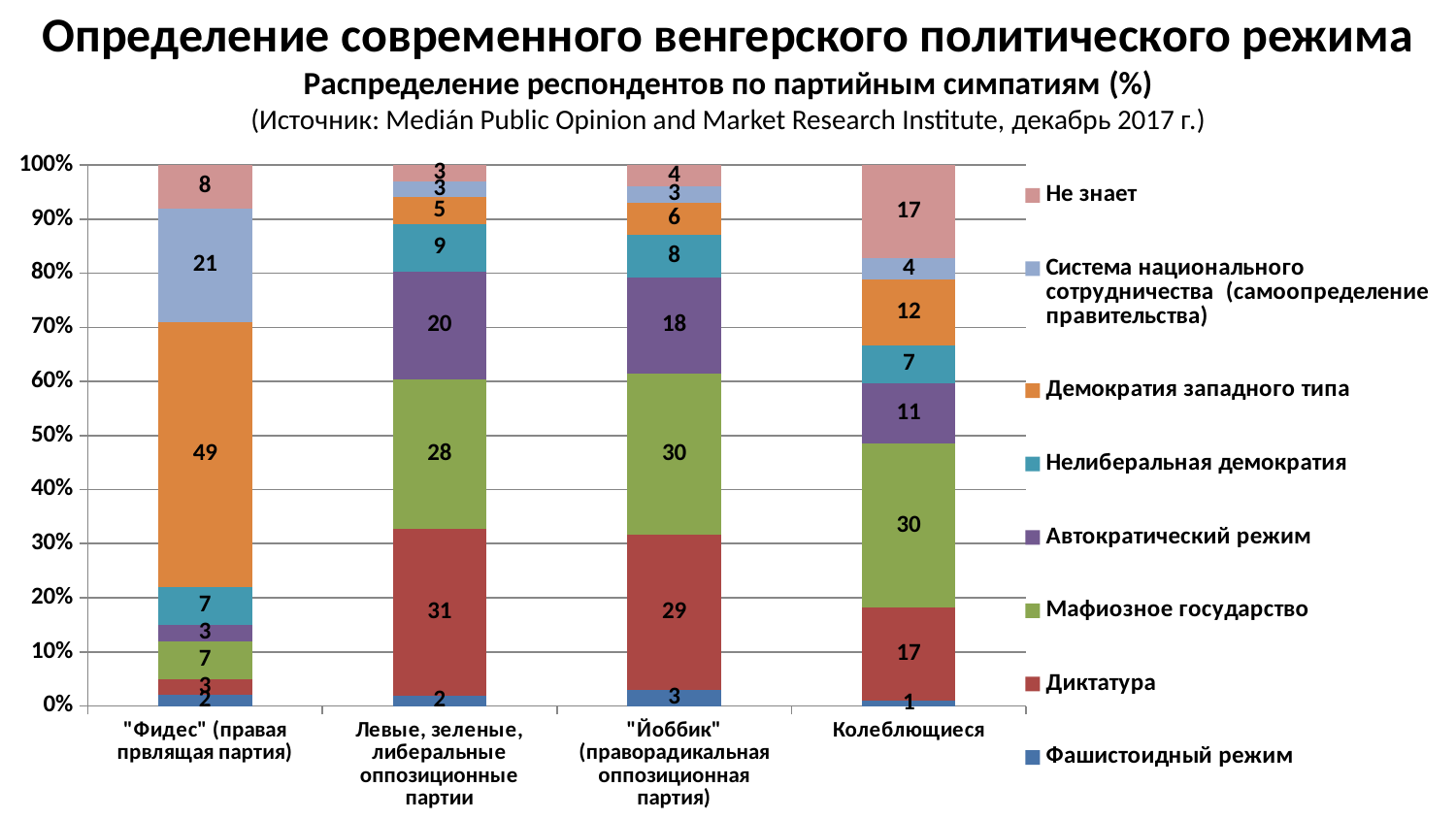
What is the value for "Не знает" among "Колеблющиеся"? 17 Which source is cited in the chart subtitle? Medián Public Opinion and Market Research Institute, декабрь 2017 г. What is the difference between the "Демократия западного типа" values for "Фидес" and "Колеблющиеся"? 37 What kind of chart is shown on the slide? stacked bar chart What is the value for "Мафиозное государство" among "Йоббик" supporters? 30 What is the value for "Демократия западного типа" among "Фидес" supporters? 49 Which is larger: the "Автократический режим" value for "Левые, зеленые, либеральные оппозиционные партии" or for "Йоббик"? Левые, зеленые, либеральные оппозиционные партии What is the value for "Диктатура" among "Левые, зеленые, либеральные оппозиционные партии" supporters? 31 How many series does the legend list? 8 Which category has the lowest value for "Фашистоидный режим"? Колеблющиеся Which category has the highest value for "Система национального сотрудничества"? "Фидес" (правая првлящая партия) How many party-sympathy categories are shown on the x axis? 4